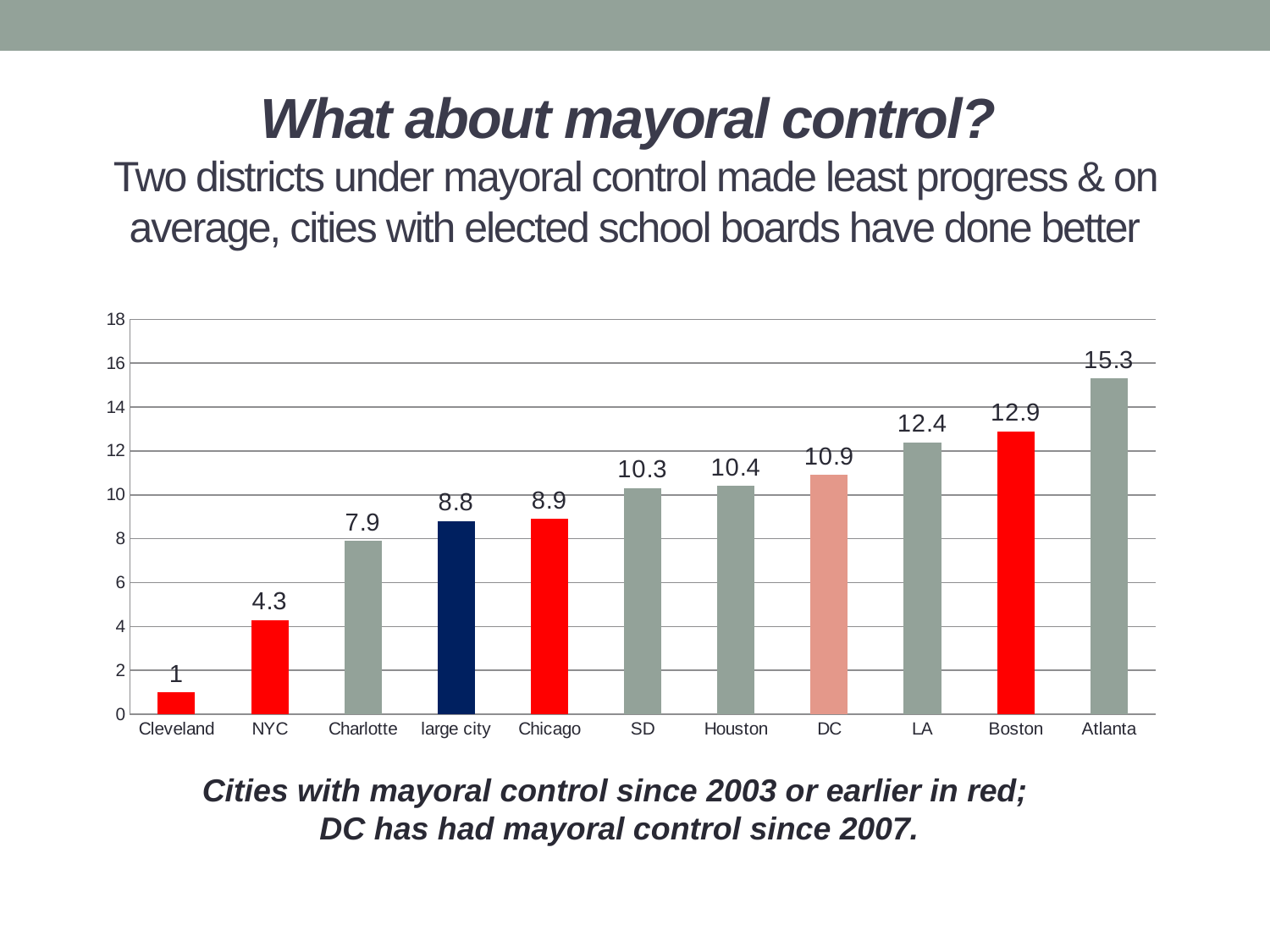
What is the difference between the values for Boston and NYC? 8.6 What is the difference between the values for Atlanta and Cleveland? 14.3 What is the value for Chicago? 8.9 What is the value for DC? 10.9 What kind of chart is shown on the slide? bar chart Which category has the lowest value? Cleveland Do the values rise or fall from left to right along the x axis? rise Is the value for Charlotte greater or less than 8? less Which category has the highest value? Atlanta Which is larger, the value for LA or the value for Houston? LA What is the value for the large city bar? 8.8 How many categories are shown on the x axis? 11